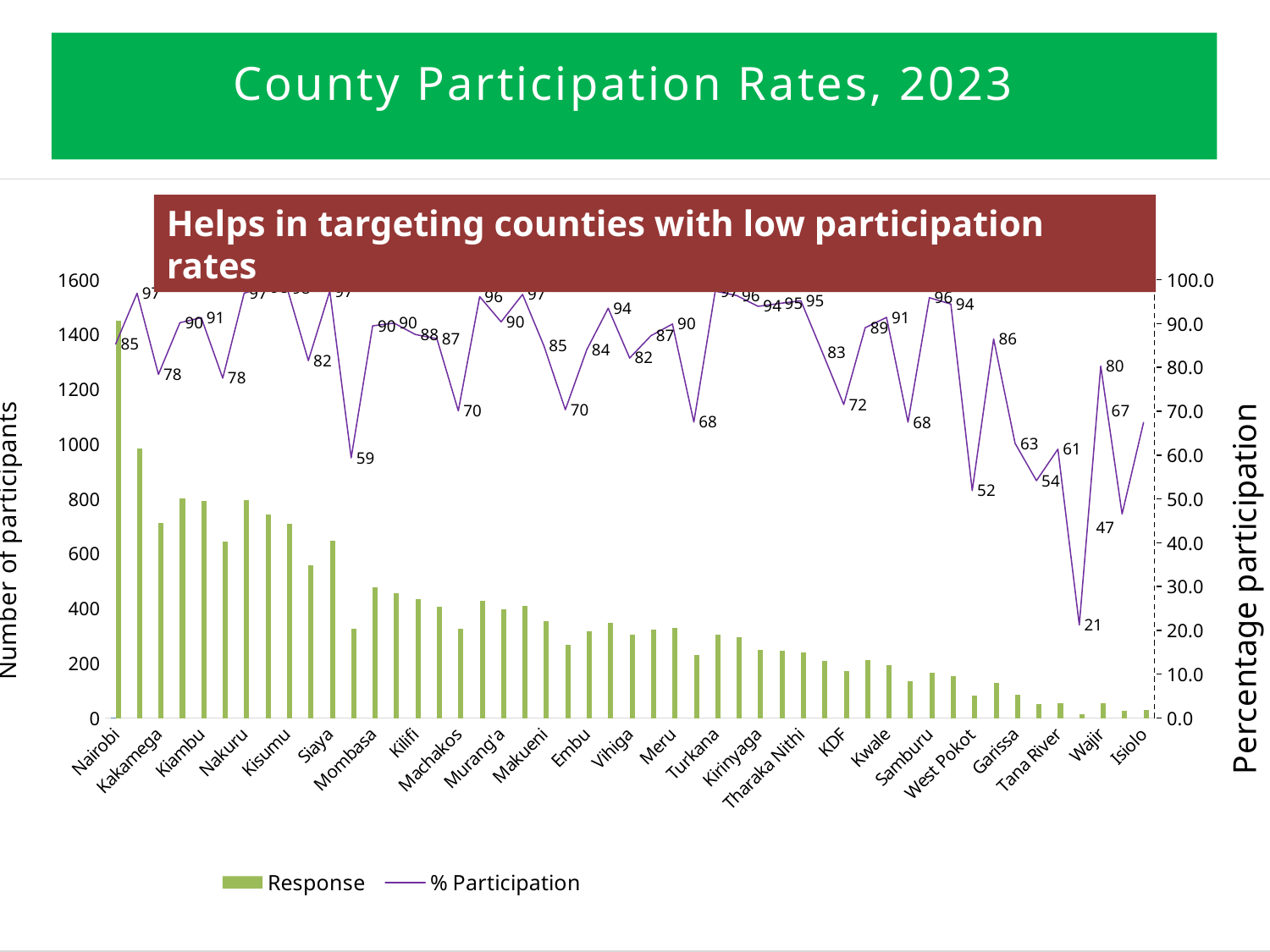
What is the % Participation value for Nairobi? 85 Do the Response bars generally rise or fall from left to right across the counties? fall Is the Response value for Isiolo greater or less than 200? less Which has the larger Response value, Nairobi or Kakamega? Nairobi Is the Response value for Nairobi greater or less than 1400? greater What are the two series named in the legend? Response and % Participation How many series does the legend list? 2 What is the % Participation value for Isiolo? 67 What is the title of the chart? County Participation Rates, 2023 What is the lowest % Participation value labelled on the line? 21 What kind of chart is shown on the slide? Combined bar and line chart Which county has the highest Response bar? Nairobi